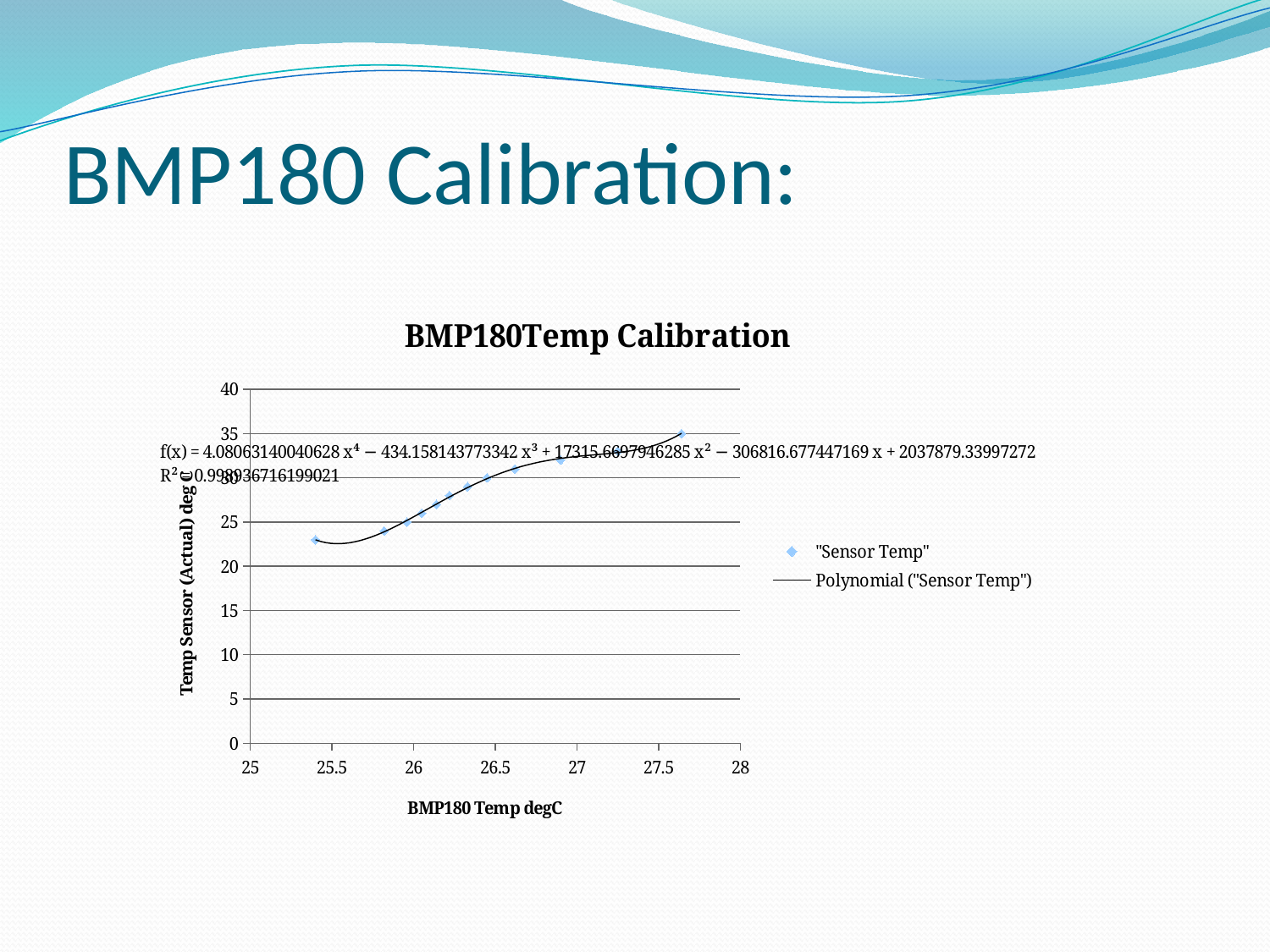
Do the Sensor Temp values rise or fall as the BMP180 temperature increases along the x axis? rise Is the Sensor Temp value for the point near 26.9 on the x axis greater or less than 30? greater What kind of chart is shown on the slide? scatter chart What is the label of the x axis? BMP180 Temp degC Is the Sensor Temp value for the point near 25.8 on the x axis greater or less than 20? greater What is the title of the chart? BMP180Temp Calibration How many entries does the chart legend list? 2 Which point has the highest Sensor Temp value: the one near 25.4 or the one near 27.6 on the x axis? the one near 27.6 Is the Sensor Temp value for the rightmost point (near 27.6 on the x axis) greater or less than 30? greater